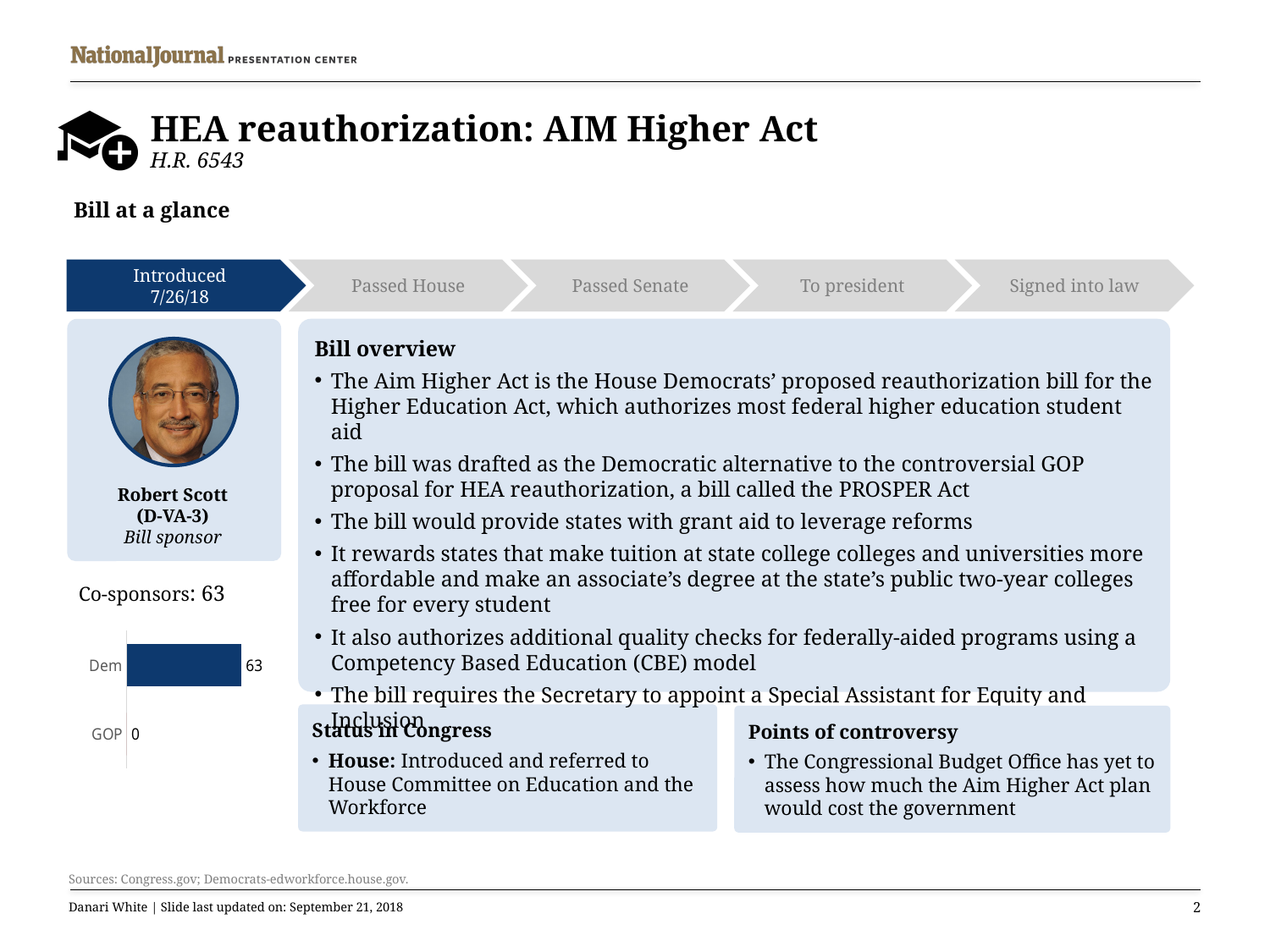
What is the value for GOP in the co-sponsors chart? 0 What is the difference between the Dem and GOP values in the co-sponsors chart? 63 Which category has the lowest value in the co-sponsors chart? GOP Which category has the highest value in the co-sponsors chart? Dem What is the value for Dem in the co-sponsors chart? 63 Which is larger in the co-sponsors chart, Dem or GOP? Dem How many categories are shown in the co-sponsors chart? 2 What kind of chart is the co-sponsors chart? bar chart What is the total number of co-sponsors shown above the chart? 63 What colour is the Dem bar in the co-sponsors chart? dark blue